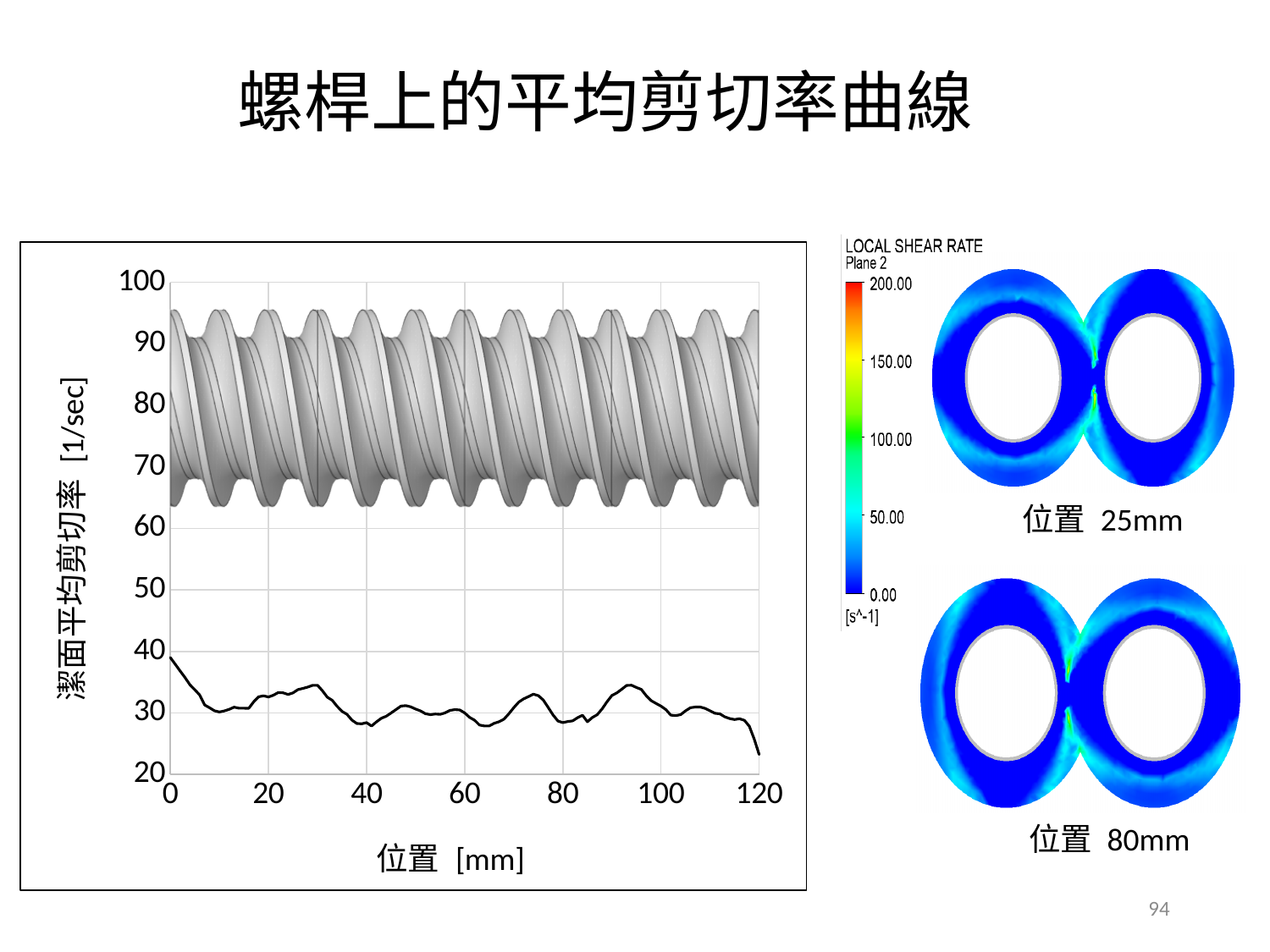
At which position on the x axis does the line chart reach its lowest value? 120 mm In the line chart, is the value at position 120 mm greater or less than 30? less In the line chart, is the value at position 40 mm greater or less than 30? less What is the maximum value shown on the x axis of the line chart? 120 At which position on the x axis does the line chart reach its highest value? 0 mm What is the label of the y axis of the line chart? 潔面平均剪切率 [1/sec] In the line chart, is the value at position 0 mm greater or less than 30? greater What kind of chart is shown on the left of the slide? line chart What is the label of the x axis of the line chart? 位置 [mm] How many lines are plotted in the line chart? 1